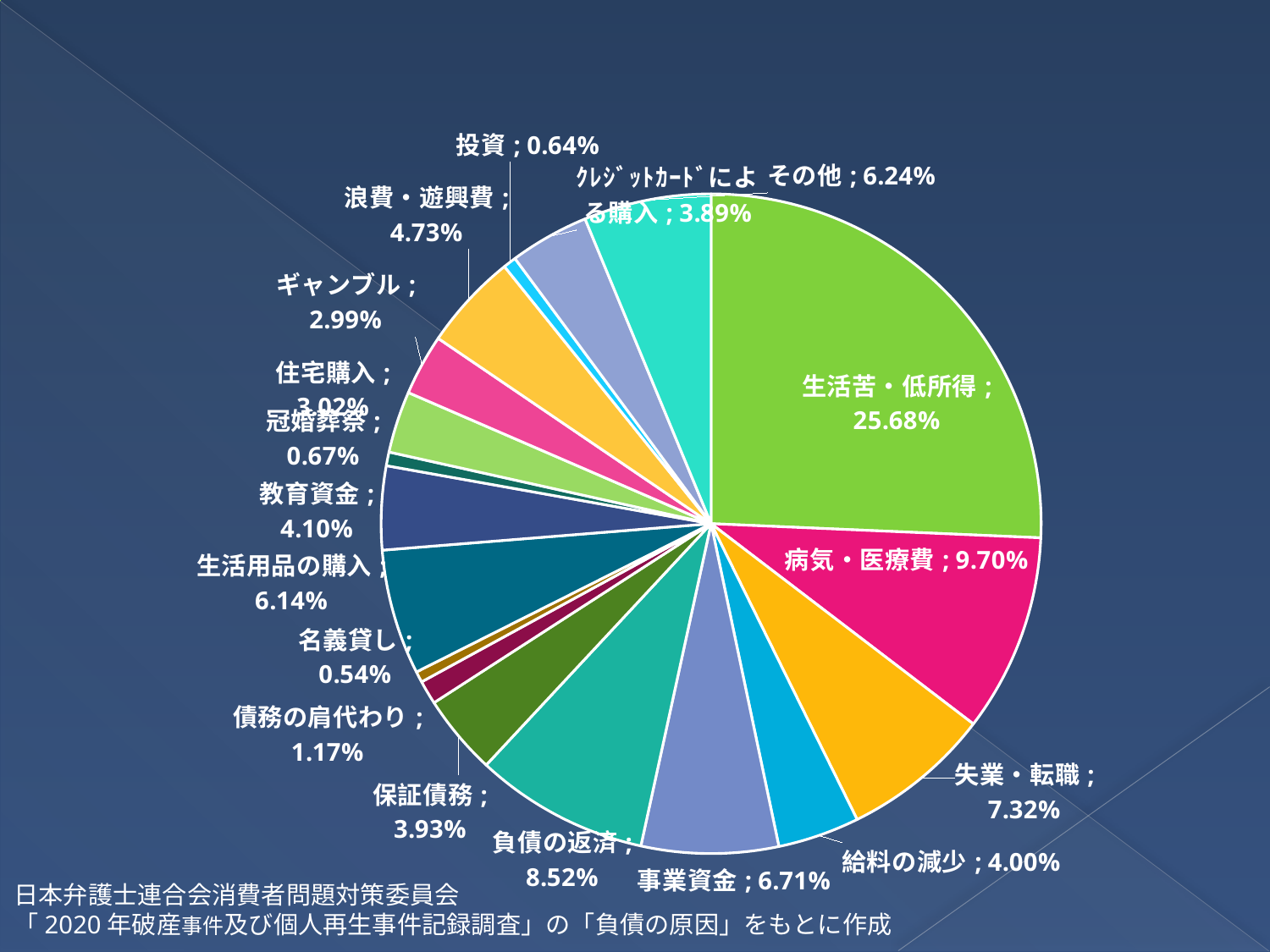
What percentage is shown for その他? 6.24% Which category has the largest share of the pie? 生活苦・低所得 What percentage is shown for 病気・医療費? 9.70% What percentage is shown for 負債の返済? 8.52% How many slices does the pie chart have? 18 What is the combined share of 教育資金 and 給料の減少? 8.10% Which category has the smallest share of the pie? 名義貸し What type of chart is shown on the slide? pie chart What percentage is shown for クレジットカードによる購入? 3.89% What is the difference between the shares of 生活苦・低所得 and 病気・医療費? 15.98% Which is larger, the share for 失業・転職 or the share for 事業資金? 失業・転職 What percentage is shown for 生活苦・低所得? 25.68%